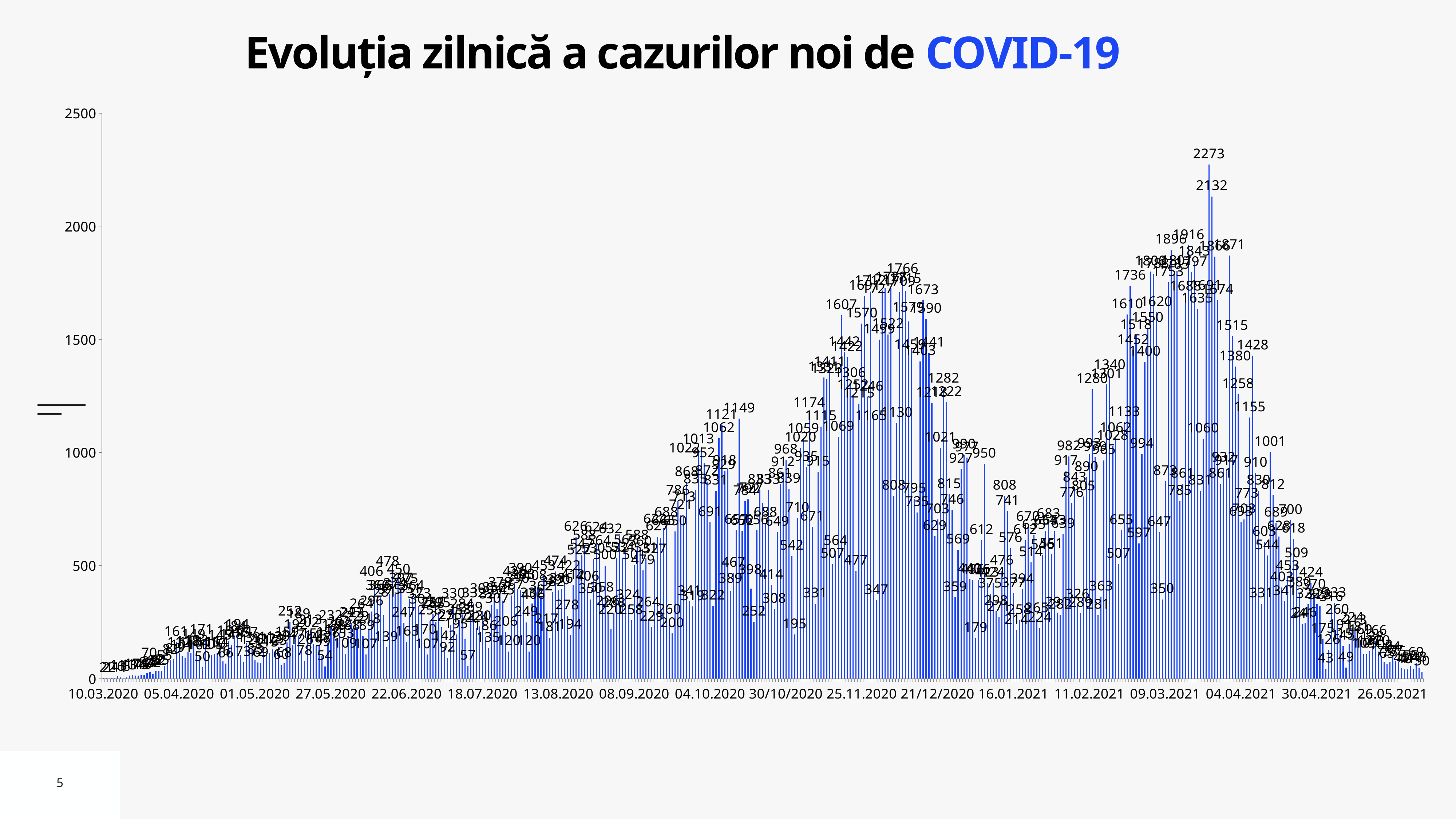
What is the difference between the two highest labelled values, 2273 and 2132? 141 What kind of chart is shown on the slide? bar chart What is the last date label shown on the x axis? 26.05.2021 Do the daily values generally rise or fall between 10.03.2020 and 22.06.2020? rise What is the first date label shown on the x axis? 10.03.2020 What is the highest daily value labelled on the chart? 2273 Which is larger, the peak around 25.11.2020 (1766) or the peak around 04.04.2021 (2273)? 2273 Is the highest bar on the chart greater or less than 2000? greater What is the second highest daily value labelled on the chart? 2132 Does any bar on the chart reach the 2500 mark on the y axis? No Do the daily values generally rise or fall between 04.04.2021 and 26.05.2021? fall What is the title of the chart? Evoluția zilnică a cazurilor noi de COVID-19